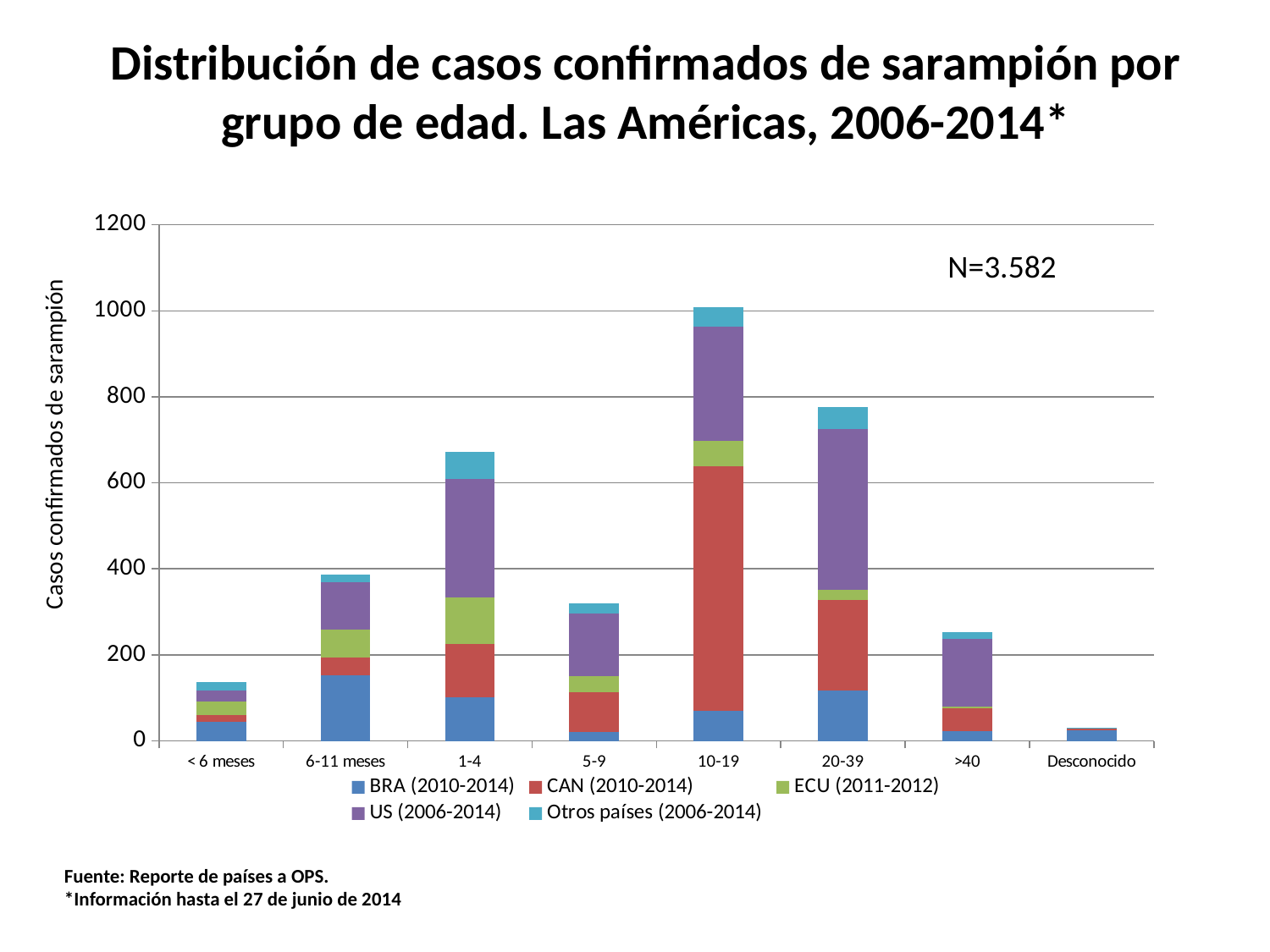
Which age group has the highest total number of confirmed measles cases? 10-19 Which age group has the lowest total number of confirmed measles cases? Desconocido How many series does the legend list? 5 Is the total value for the < 6 meses age group greater or less than 200? less What total N is stated on the chart? N=3.582 What kind of chart is shown on the slide? stacked bar chart Is the total value for the 10-19 age group greater or less than 800? greater Is the total value for the 20-39 age group greater or less than 800? less What is the label of the y axis? Casos confirmados de sarampión How many age-group categories are shown on the x axis? 8 Which has a larger total of confirmed cases, the 1-4 age group or the 5-9 age group? 1-4